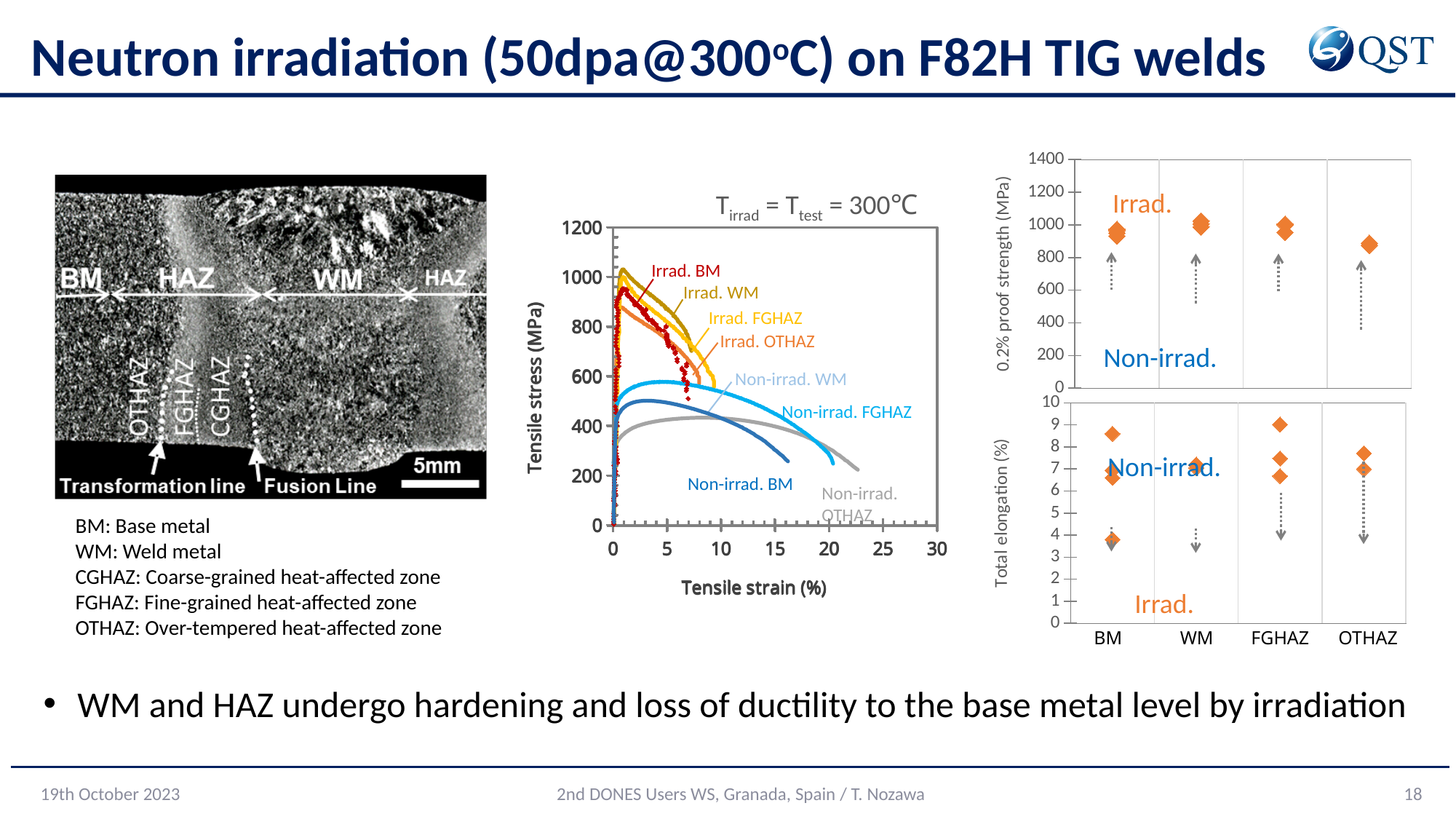
In the top-right 0.2% proof strength chart, is the irradiated value for OTHAZ greater or less than 1000 MPa? less What kind of chart is the middle chart of tensile stress versus tensile strain? line chart In the middle tensile stress chart, is the peak tensile stress of the Non-irrad. OTHAZ curve greater or less than 600 MPa? less In the middle tensile stress chart, is the peak tensile stress of the Irrad. WM curve greater or less than 800 MPa? greater In the middle tensile stress chart, how many curves are labelled? 8 How many categories are shown on the x axis of the right-hand charts? 4 In the middle tensile stress chart, what is the maximum value shown on the tensile stress axis? 1200 In the top-right 0.2% proof strength chart, which category has the lowest irradiated proof strength? OTHAZ In the middle tensile stress chart, which curve reaches a larger tensile strain before ending, Non-irrad. OTHAZ or Non-irrad. BM? Non-irrad. OTHAZ In the middle tensile stress chart, which curve reaches a higher peak tensile stress, Irrad. WM or Non-irrad. WM? Irrad. WM